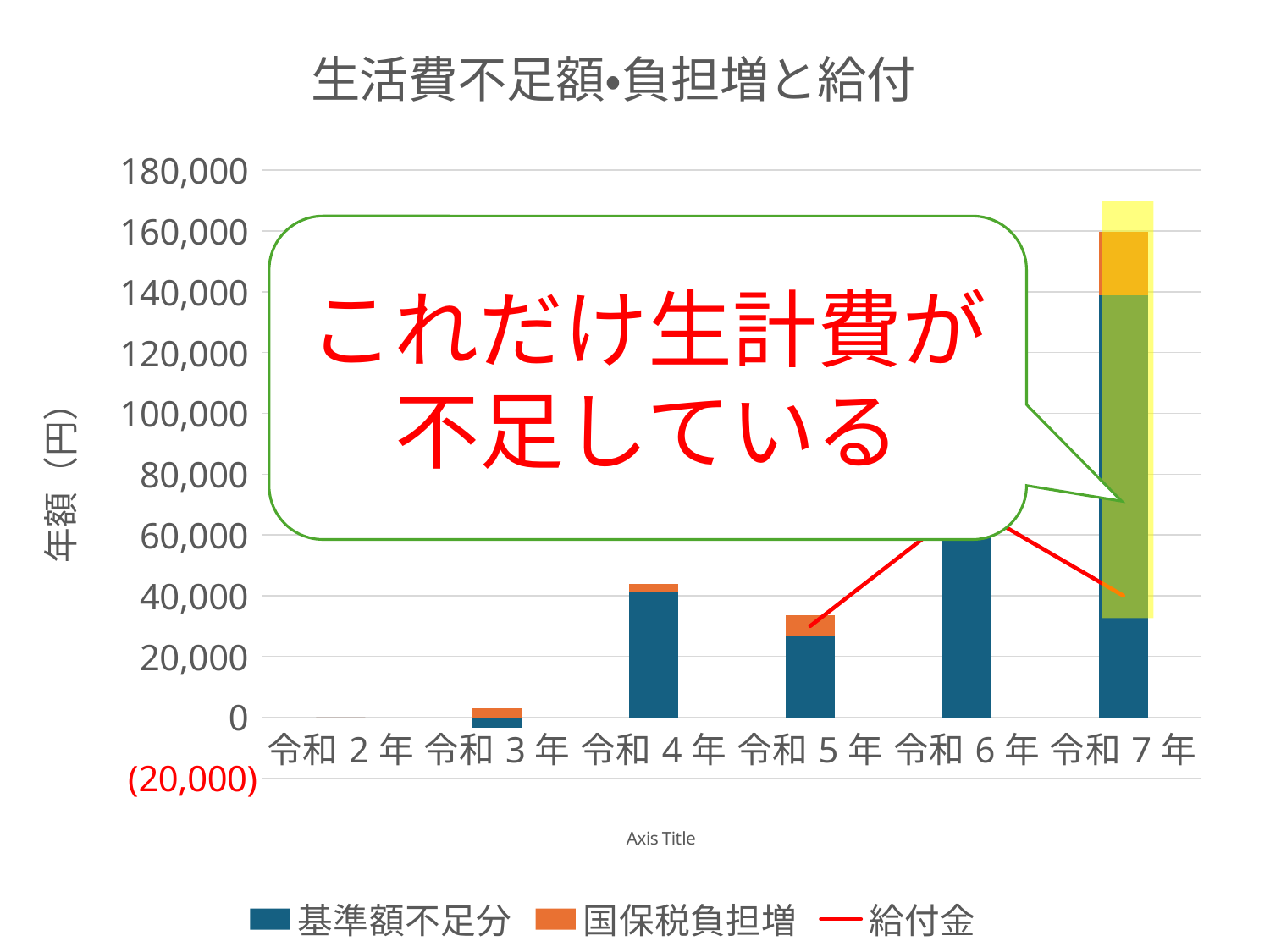
How many categories are shown on the x axis? 6 How many series does the legend list? 3 What is the title of the chart? 生活費不足額•負担増と給付 Which category has the highest value for 基準額不足分? 令和７年 Which is larger, the 基準額不足分 value for 令和６年 or for 令和７年? 令和７年 Which is larger, the 基準額不足分 value for 令和４年 or for 令和５年? 令和４年 Is the value for 基準額不足分 in 令和６年 greater or less than 40,000? greater Is the value for 基準額不足分 in 令和４年 greater or less than 20,000? greater Is the value for 基準額不足分 in 令和７年 greater or less than 40,000? greater Which series is drawn as a red line according to the legend? 給付金 What kind of chart is shown on the slide? combination bar and line chart